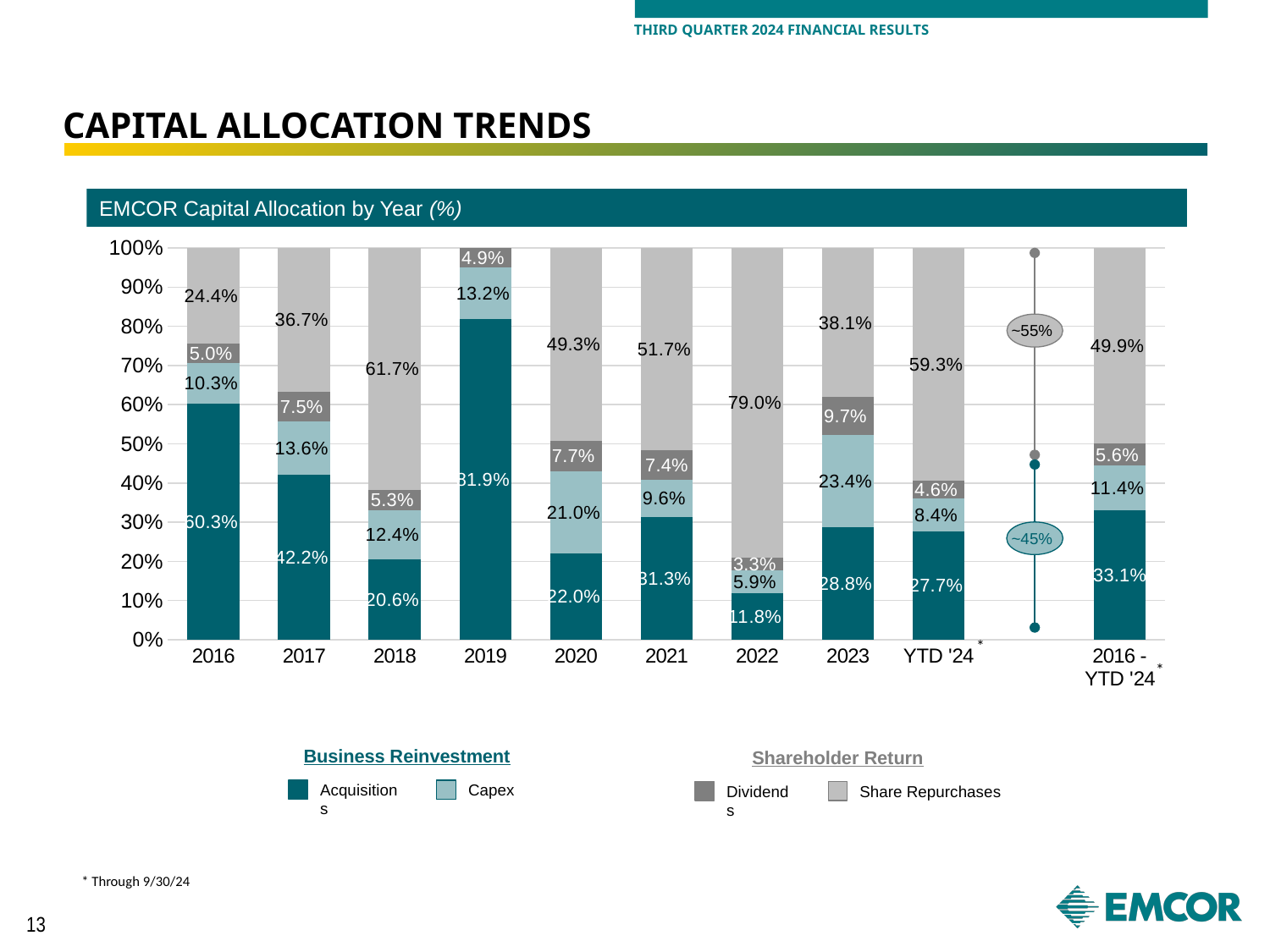
How many series does the legend list? 4 What was the Share Repurchases percentage in 2022? 79.0% How many categories are shown on the x axis of the chart? 10 What type of chart is shown on the slide? Stacked bar chart What is the difference between the Share Repurchases percentage in 2018 and in 2017? 25.0% In which year was the Acquisitions percentage the highest? 2019 What was the Dividends percentage for YTD '24? 4.6% In which year was the Acquisitions percentage the lowest? 2022 Which was larger in 2020, the Acquisitions percentage or the Capex percentage? Acquisitions What percentage of capital allocation went to Acquisitions in 2016? 60.3% What was the Capex percentage in 2023? 23.4% In which year was the Share Repurchases percentage the highest? 2022